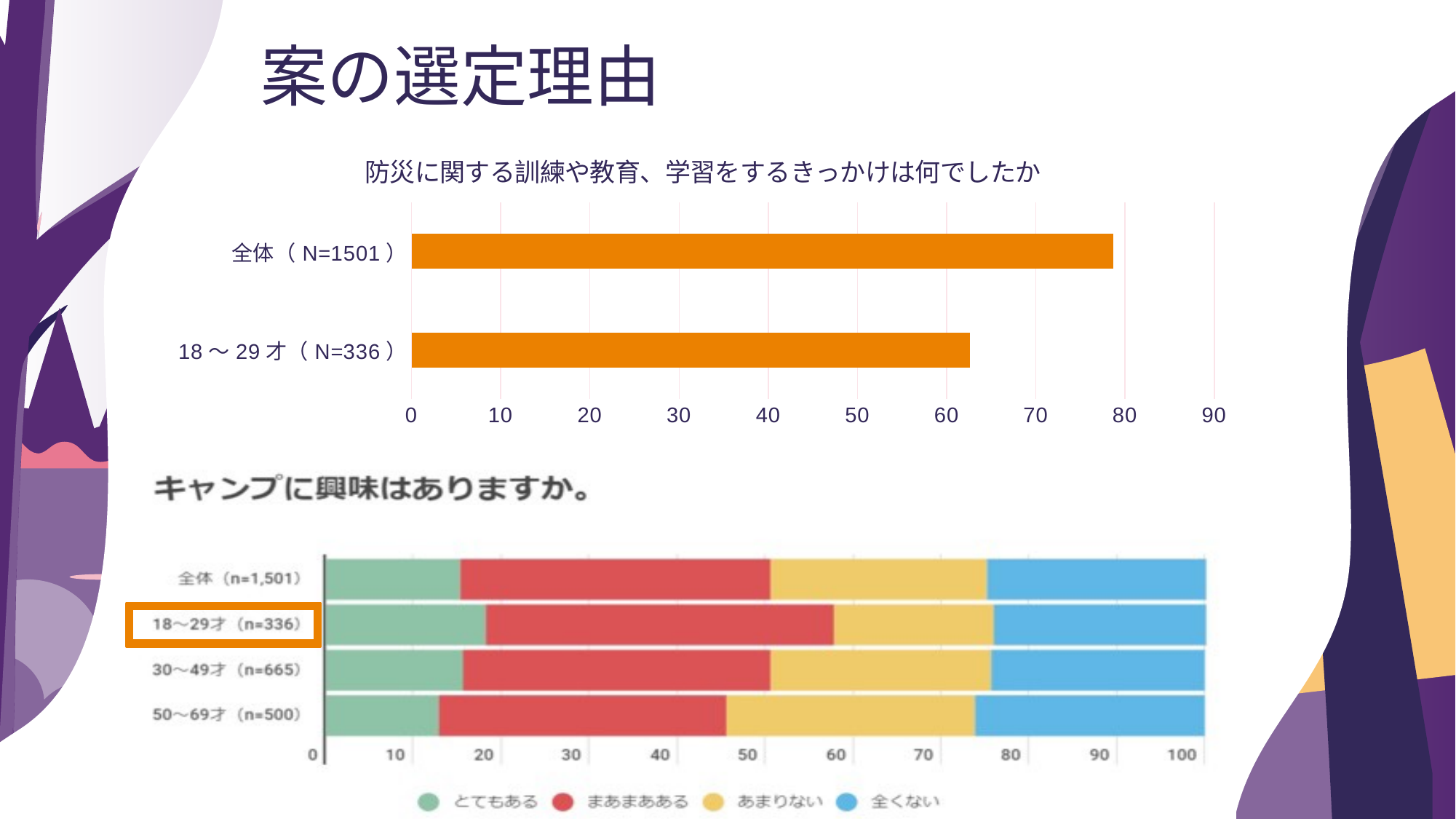
In the bottom chart 「キャンプに興味はありますか。」, how many age-group categories are plotted? 4 What kind of chart is the bottom chart titled 「キャンプに興味はありますか。」? stacked bar chart In the bottom chart 「キャンプに興味はありますか。」, how many series does the legend list? 4 In the top chart 「防災に関する訓練や教育、学習をするきっかけは何でしたか」, is the value for 全体（N=1501） greater or less than 70? greater In the bottom chart 「キャンプに興味はありますか。」, which category has the largest まあまあある segment? 18〜29才（n=336） In the top chart 「防災に関する訓練や教育、学習をするきっかけは何でしたか」, which category has the higher value? 全体（N=1501） In the top chart 「防災に関する訓練や教育、学習をするきっかけは何でしたか」, is the value for 18〜29才（N=336） greater or less than 70? less In the top chart 「防災に関する訓練や教育、学習をするきっかけは何でしたか」, which is larger: the value for 全体（N=1501） or for 18〜29才（N=336）? 全体（N=1501） In the top chart 「防災に関する訓練や教育、学習をするきっかけは何でしたか」, how many categories are plotted? 2 In the bottom chart 「キャンプに興味はありますか。」, what are the four legend entries? とてもある, まあまあある, あまりない, 全くない What kind of chart is the top chart titled 「防災に関する訓練や教育、学習をするきっかけは何でしたか」? bar chart